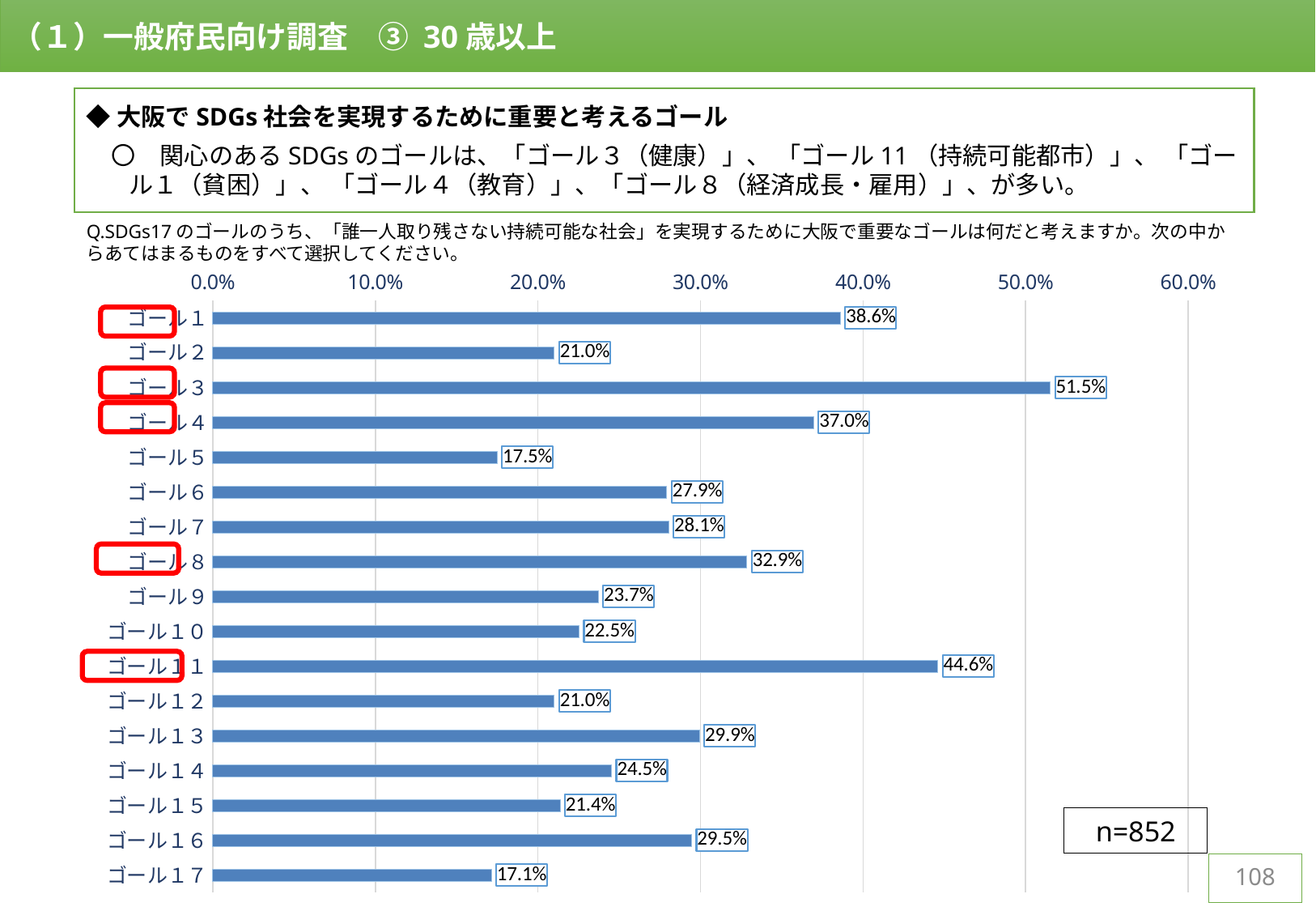
What is the value for ゴール８? 32.9% How many goals (categories) are plotted in the chart? 17 What is the value for ゴール１? 38.6% Which is larger, the value for ゴール８ or the value for ゴール１３? ゴール８ Which goal has the lowest value? ゴール１７ What is the value for ゴール３? 51.5% What is the value for ゴール１１? 44.6% Which goal has the highest value? ゴール３ Is the value for ゴール１１ greater or less than 40.0%? greater What kind of chart is shown on the slide? bar chart What is the sample size (n) shown on the chart? n=852 What is the difference between the values for ゴール３ and ゴール１１? 6.9 percentage points